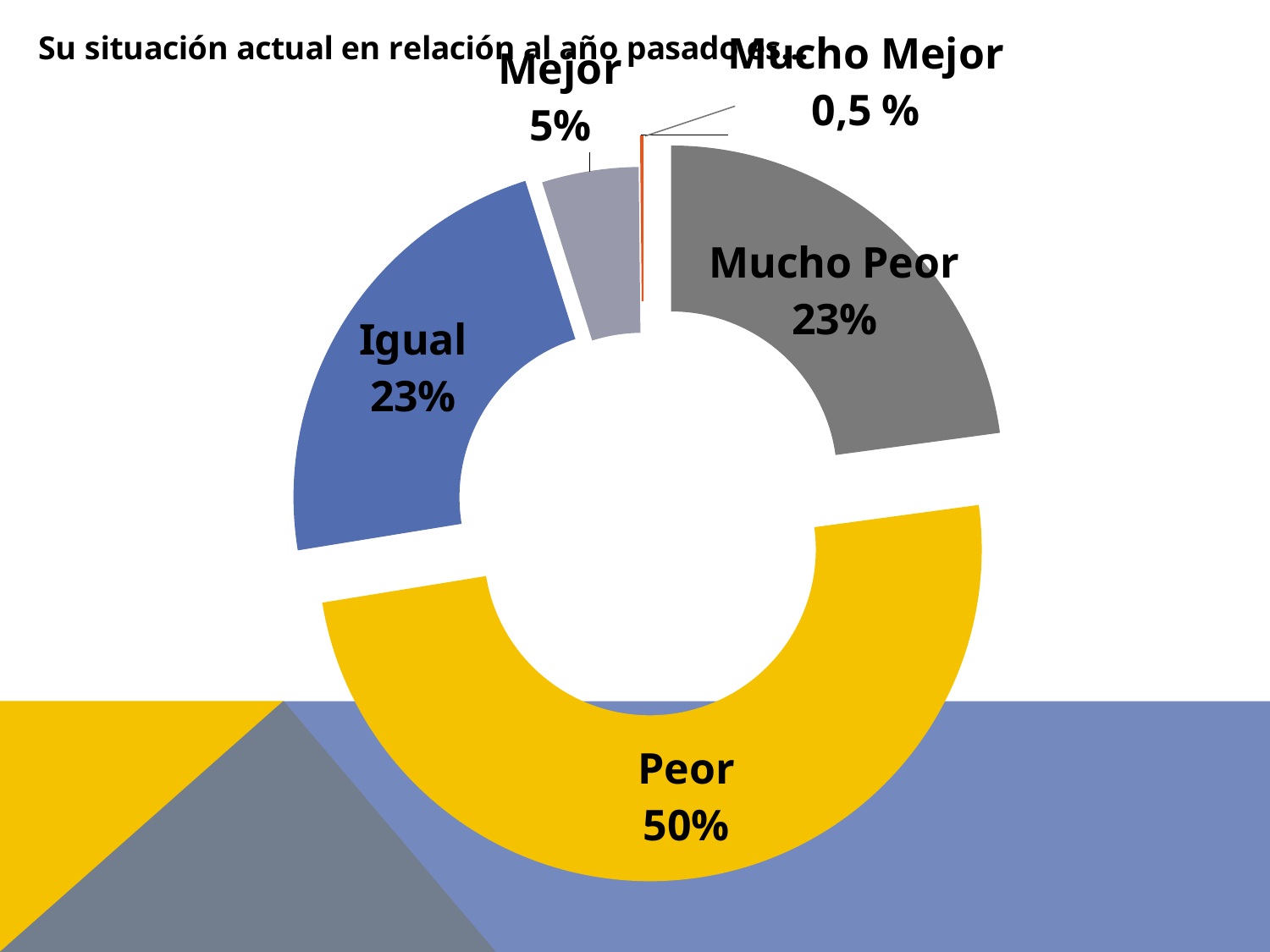
Which is larger, the share for "Mejor" or the share for "Mucho Mejor"? Mejor What is the difference in percentage points between "Peor" and "Igual"? 27 Which category has the smallest share of the chart? Mucho Mejor What percentage is shown for the "Peor" segment? 50% What kind of chart is shown on the slide? Doughnut chart What percentage is shown for the "Mucho Mejor" segment? 0,5 % Which category has the largest share of the chart? Peor What percentage is shown for the "Mejor" segment? 5% What is the combined share of "Igual" and "Mucho Peor"? 46% What percentage is shown for the "Igual" segment? 23% How many categories are shown in the chart? 5 What colour is the "Peor" segment of the chart? Yellow